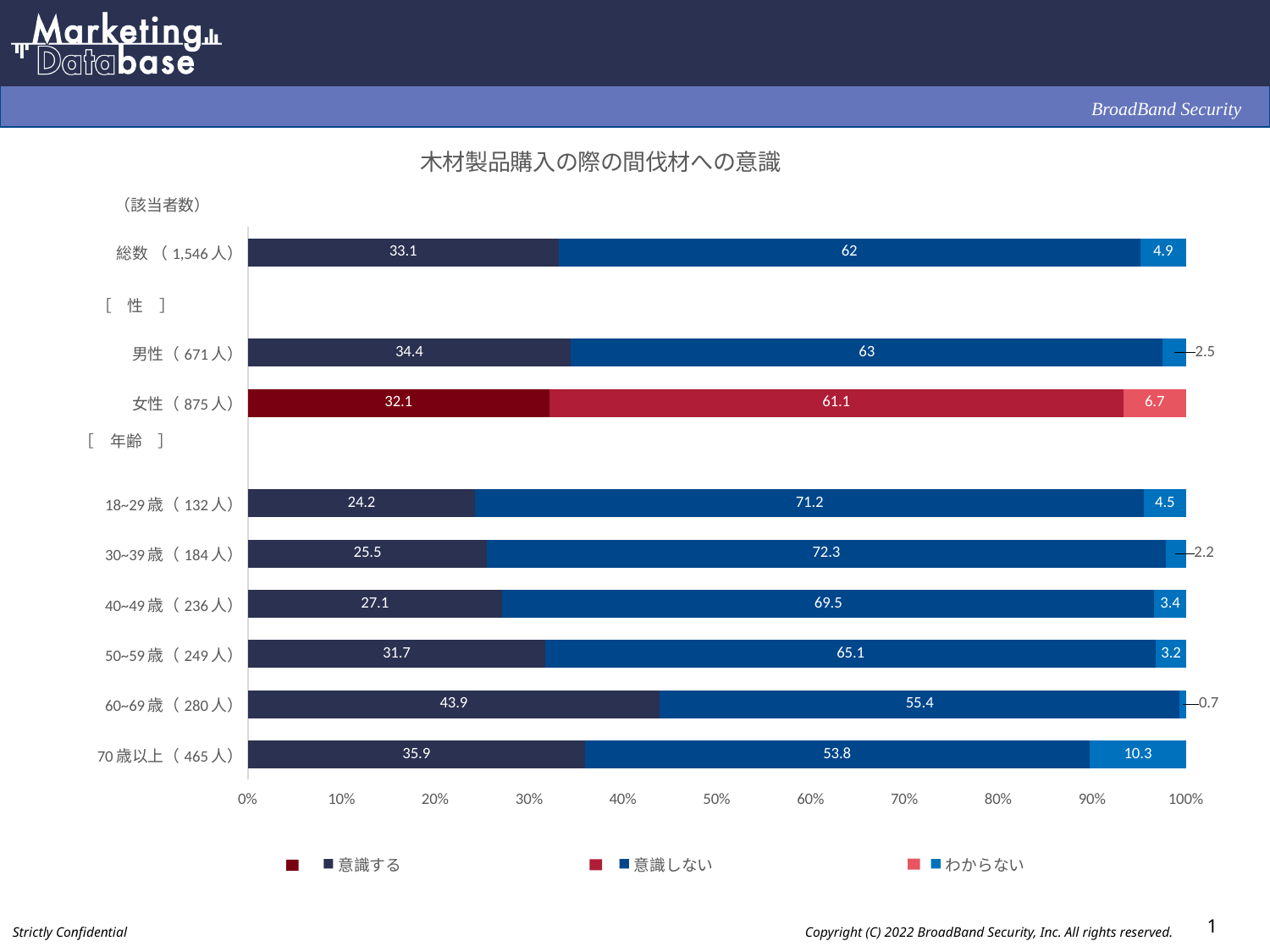
Which age group has the highest value for 意識する? 60~69歳 (280人) What is the value of わからない for 男性 (671人)? 2.5 What type of chart is shown on the slide? Stacked bar chart What is the value of 意識しない for 30~39歳 (184人)? 72.3 What is the value of わからない for 70歳以上 (465人)? 10.3 What is the difference between the 意識する values for 男性 (671人) and 女性 (875人)? 2.3 Which category has the lowest value for わからない? 60~69歳 (280人) Which is larger, the 意識しない value for 18~29歳 (132人) or for 70歳以上 (465人)? 18~29歳 (132人) How many bars (categories) are plotted in the chart? 9 What is the value of 意識する for 総数 (1,546人)? 33.1 How many series does the legend list? 3 What is the title of the chart? 木材製品購入の際の間伐材への意識